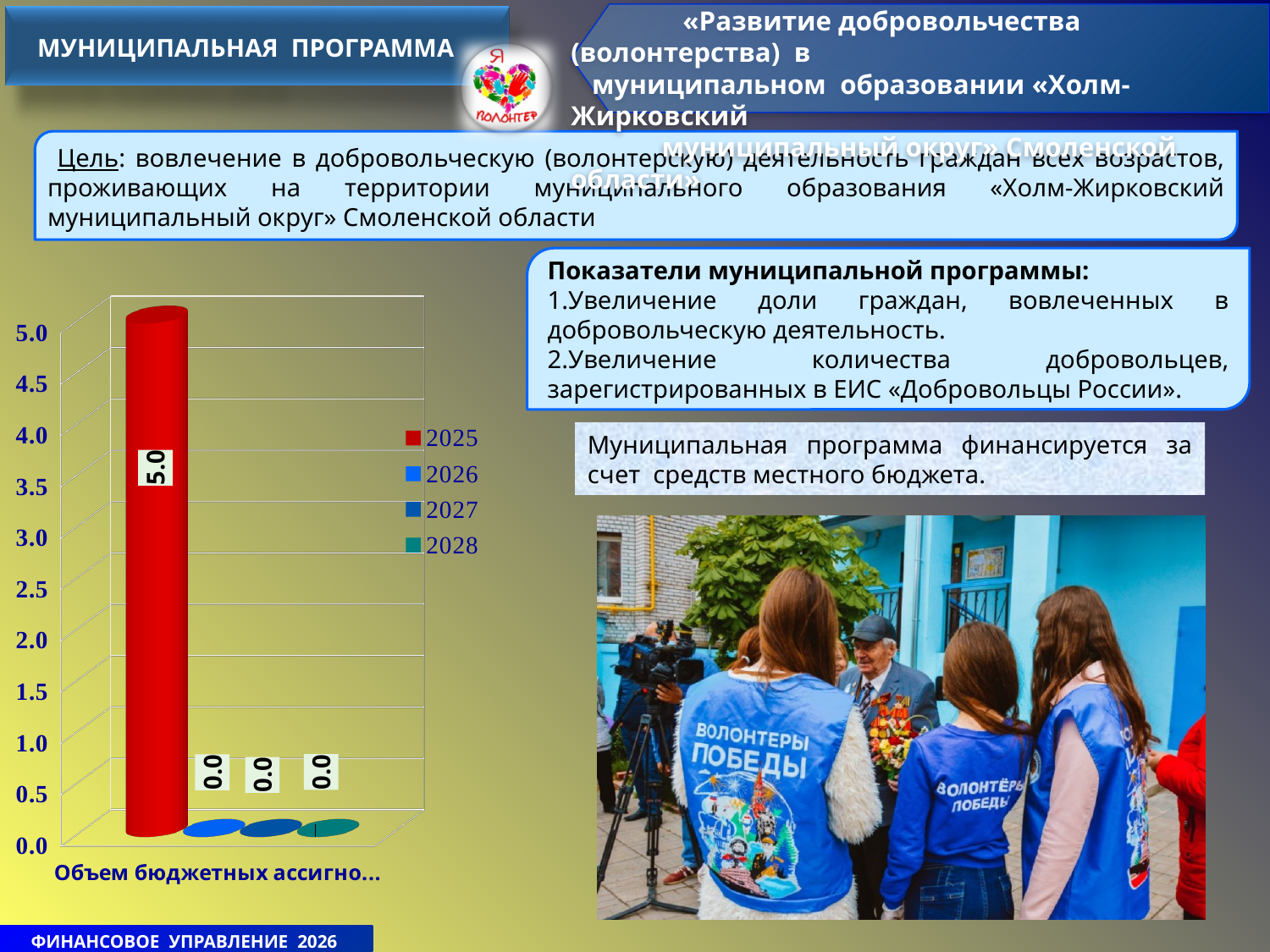
Which year has the highest value in the chart? 2025 Is the value for 2025 greater or less than 4.5? greater What colour is the bar for 2025 in the chart? red What type of chart is shown on the slide? bar chart Which is larger, the value for 2025 or the value for 2027? 2025 What is the value for 2028 in the chart? 0.0 How many series does the chart legend list? 4 What is the value for 2026 in the chart? 0.0 What is the value for 2027 in the chart? 0.0 What is the value for 2025 in the chart? 5.0 What is the highest value shown on the chart's vertical axis? 5.0 What is the difference between the values for 2025 and 2026? 5.0